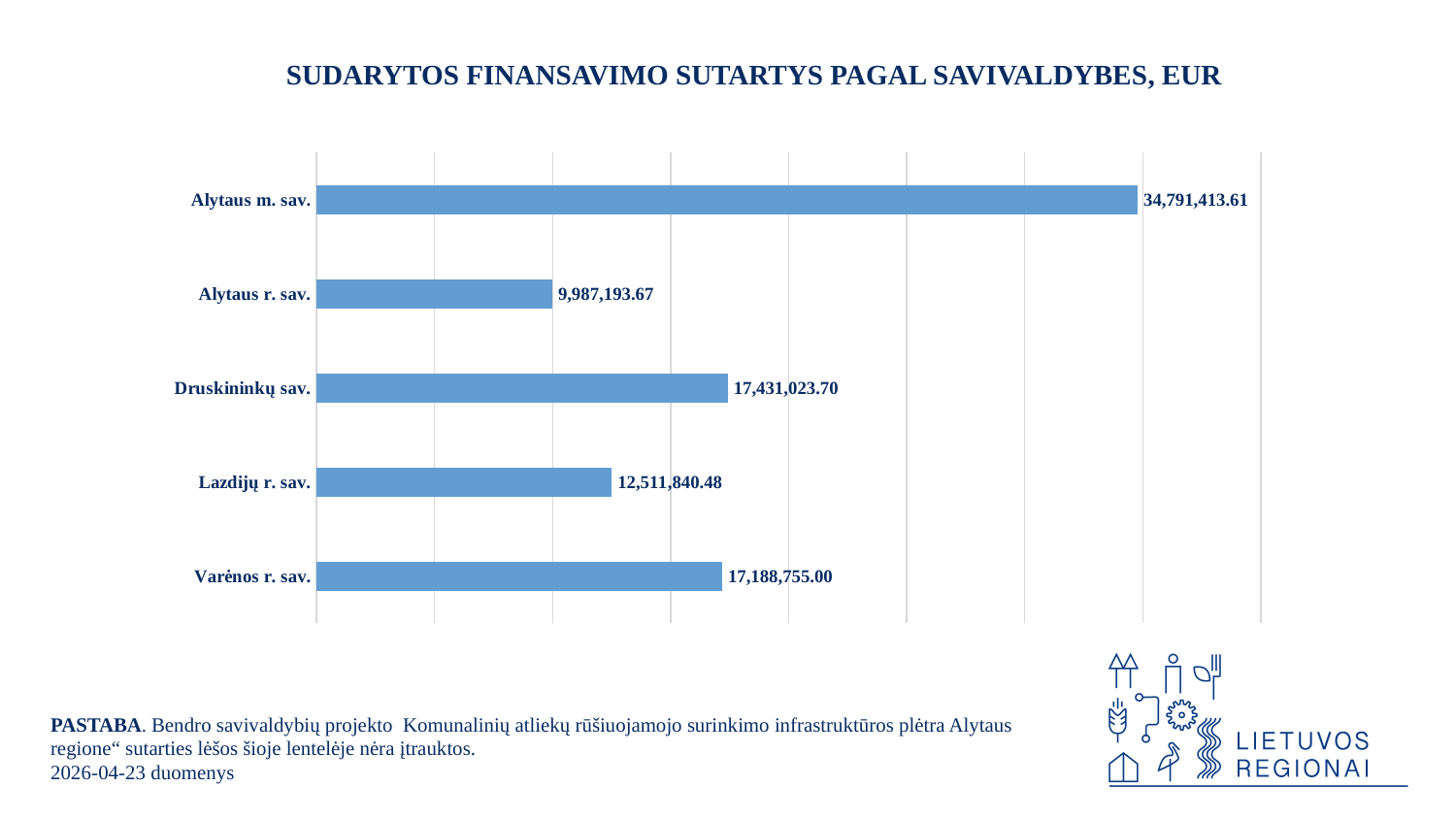
What is the value for Lazdijų r. sav.? 12,511,840.48 What kind of chart is shown on the slide? Bar chart What is the value for Alytaus r. sav.? 9,987,193.67 Which municipality has the lowest value? Alytaus r. sav. What is the value for Varėnos r. sav.? 17,188,755.00 What is the value for Druskininkų sav.? 17,431,023.70 How many municipalities are shown in the chart? 5 What is the value for Alytaus m. sav.? 34,791,413.61 What is the difference between the values for Alytaus m. sav. and Alytaus r. sav.? 24,804,219.94 Which municipality has the highest value? Alytaus m. sav. Which is larger, the value for Lazdijų r. sav. or the value for Varėnos r. sav.? Varėnos r. sav. What is the difference between the values for Druskininkų sav. and Varėnos r. sav.? 242,268.70